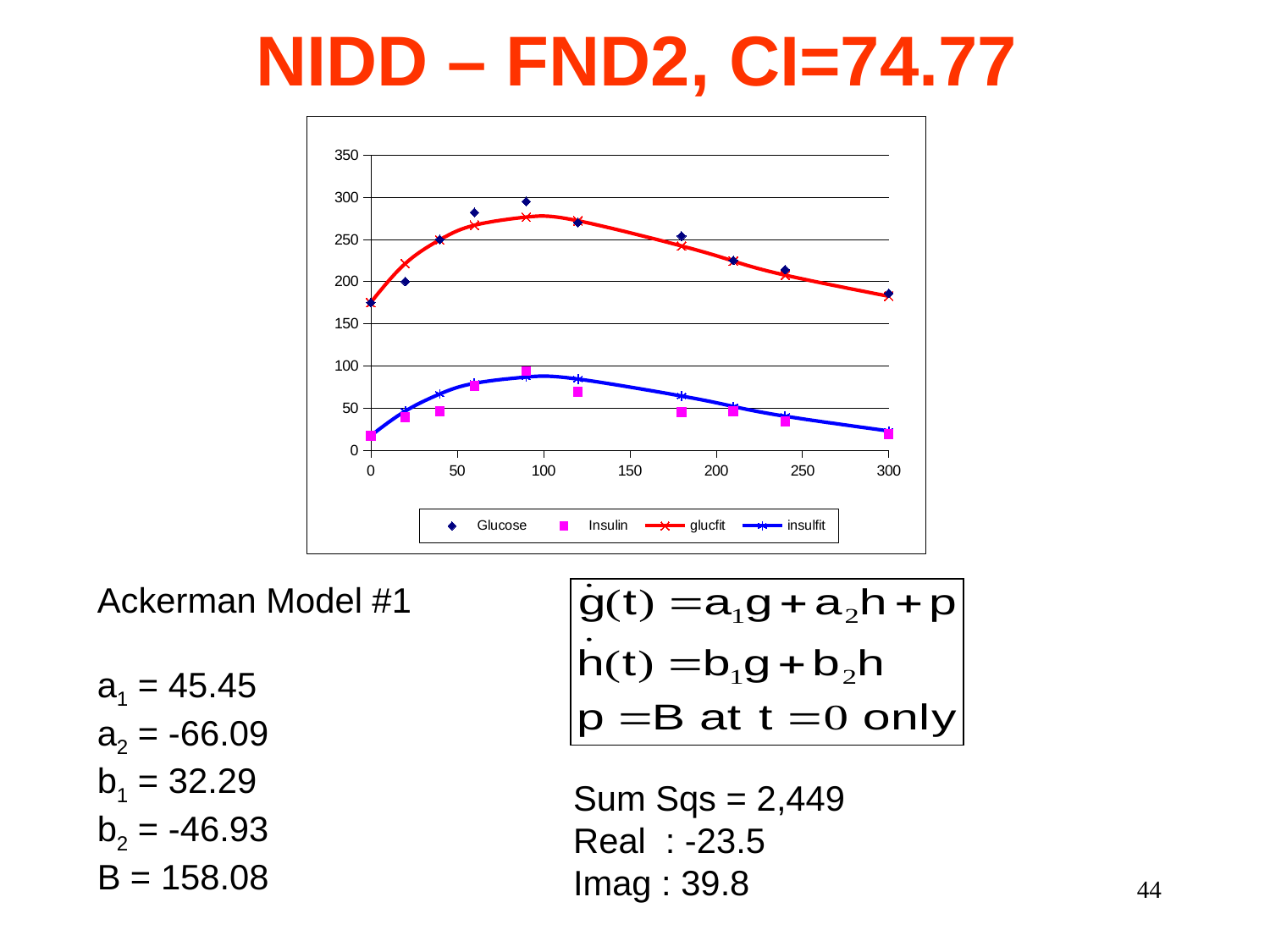
What kind of chart is shown on the slide? scatter chart with fitted lines Is the Insulin value at x = 300 greater or less than 50? less Does the insulfit curve rise or fall between x = 0 and x = 100? rise What are the names of the series listed in the chart legend? Glucose, Insulin, glucfit, insulfit Is the Glucose value at x = 300 greater or less than 200? less What is the highest value shown on the chart's y axis? 350 How many series does the chart legend list? 4 Does the glucfit curve rise or fall between x = 100 and x = 300? fall